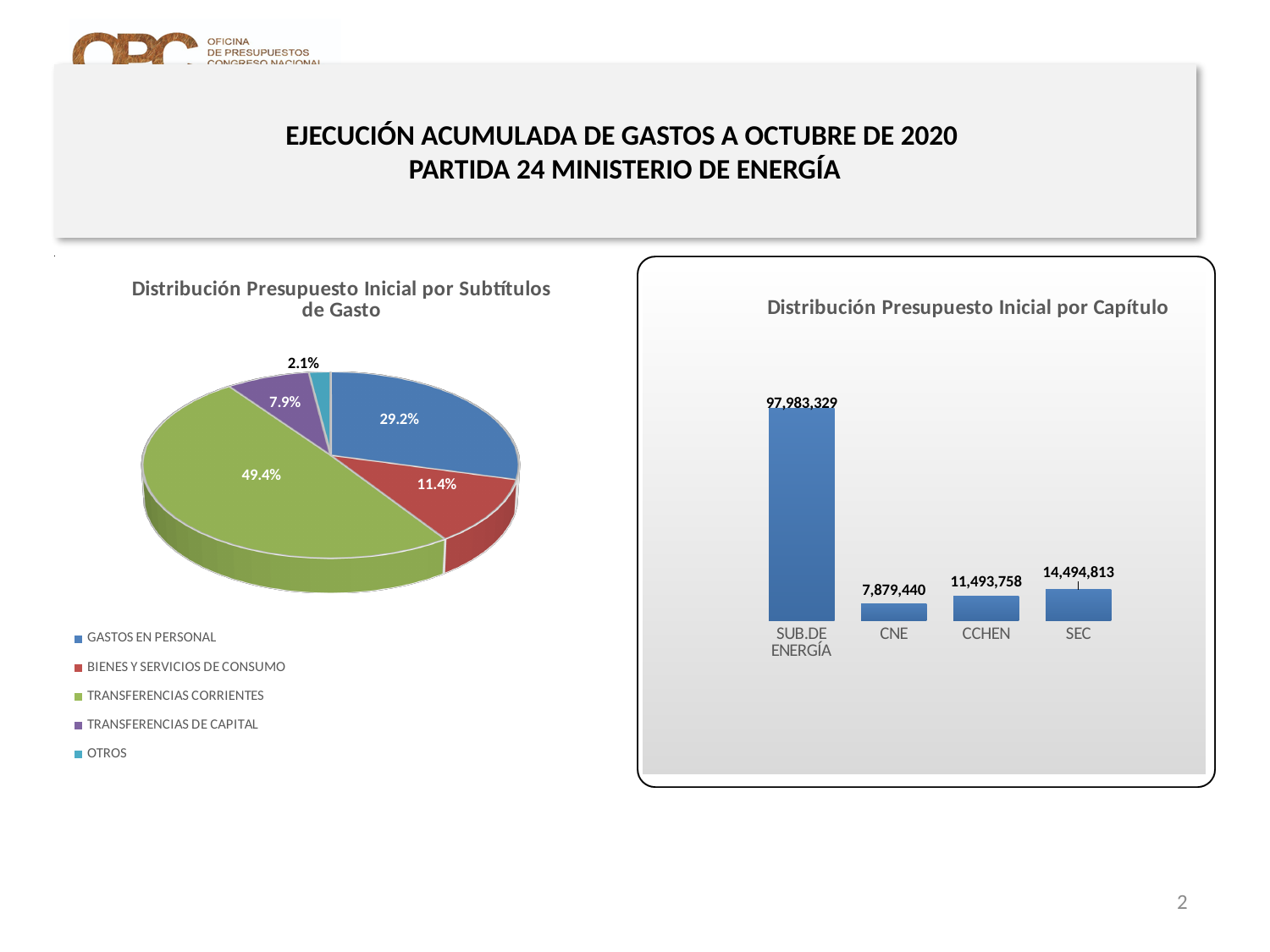
What kind of chart is 'Distribución Presupuesto Inicial por Capítulo'? Bar chart In the pie chart 'Distribución Presupuesto Inicial por Subtítulos de Gasto', what share does TRANSFERENCIAS CORRIENTES have? 49.4% In the chart 'Distribución Presupuesto Inicial por Capítulo', which category has the lowest value? CNE How many categories are shown in the chart 'Distribución Presupuesto Inicial por Capítulo'? 4 In the chart 'Distribución Presupuesto Inicial por Capítulo', what is the value for CCHEN? 11,493,758 In the chart 'Distribución Presupuesto Inicial por Capítulo', what is the value for CNE? 7,879,440 In the chart 'Distribución Presupuesto Inicial por Capítulo', which is larger, the value for CCHEN or the value for CNE? CCHEN In the chart 'Distribución Presupuesto Inicial por Capítulo', what is the value for SUB.DE ENERGÍA? 97,983,329 In the chart 'Distribución Presupuesto Inicial por Capítulo', what is the difference between the values for SEC and CCHEN? 3,001,055 In the chart 'Distribución Presupuesto Inicial por Capítulo', which category has the highest value? SUB.DE ENERGÍA In the pie chart 'Distribución Presupuesto Inicial por Subtítulos de Gasto', what share does GASTOS EN PERSONAL have? 29.2% How many entries does the legend of the pie chart 'Distribución Presupuesto Inicial por Subtítulos de Gasto' list? 5